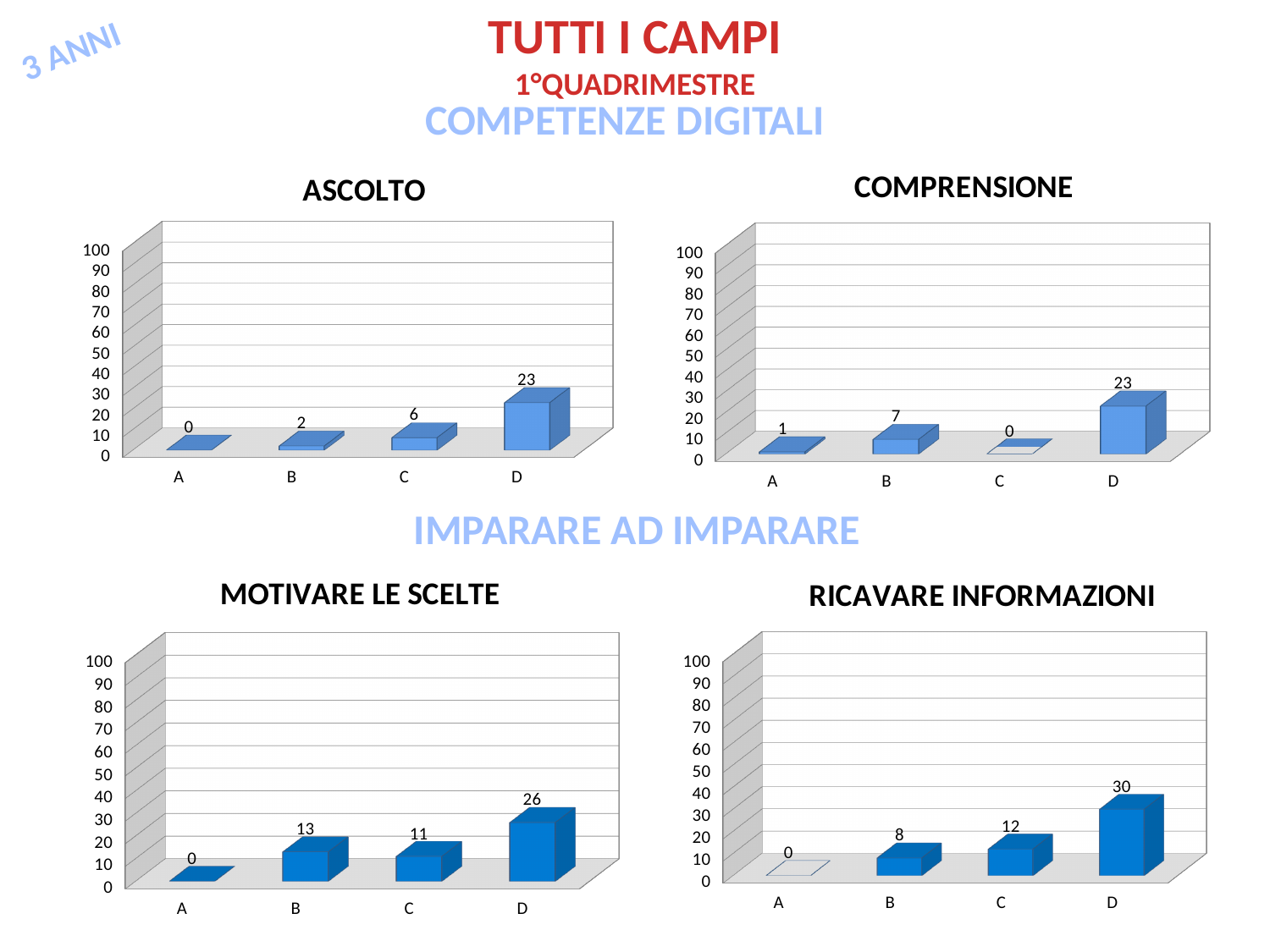
In the ASCOLTO chart, is the value for D greater or less than 30? less In the RICAVARE INFORMAZIONI chart, what is the difference between the values for D and C? 18 In the MOTIVARE LE SCELTE chart, what is the value for C? 11 In the ASCOLTO chart, what is the value for D? 23 In the COMPRENSIONE chart, which category has the lowest value? C What kind of chart is the COMPRENSIONE chart? bar chart In the RICAVARE INFORMAZIONI chart, which category has the highest value? D In the RICAVARE INFORMAZIONI chart, do the values rise or fall from A to D? rise How many categories are shown in the MOTIVARE LE SCELTE chart? 4 What is the title of the chart at the top left of the slide? ASCOLTO In the COMPRENSIONE chart, what is the value for B? 7 In the MOTIVARE LE SCELTE chart, which is larger, the value for B or the value for C? B